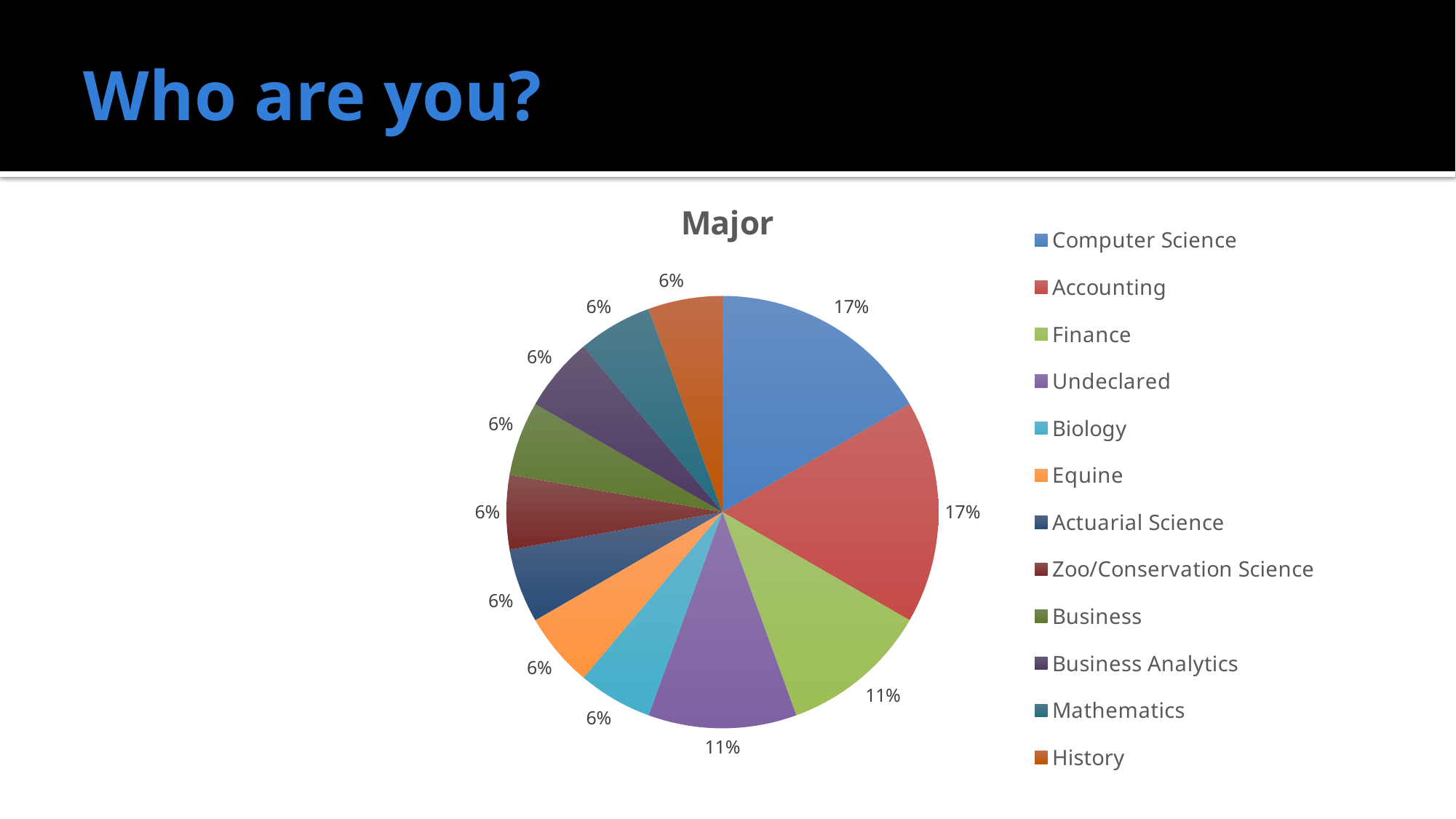
What is the value shown for History? 6% What share of the pie does Undeclared represent? 11% What is the value shown for Biology? 6% Which is larger, the share for Finance or the share for Equine? Finance What share of the pie does Accounting represent? 17% What share of the pie does Finance represent? 11% How many categories does the legend of the Major pie chart list? 12 What is the title of the chart? Major What is the largest percentage shown on any slice of the pie? 17% What kind of chart is shown on the slide? pie chart What is the difference in percentage points between the Computer Science share and the Finance share? 6